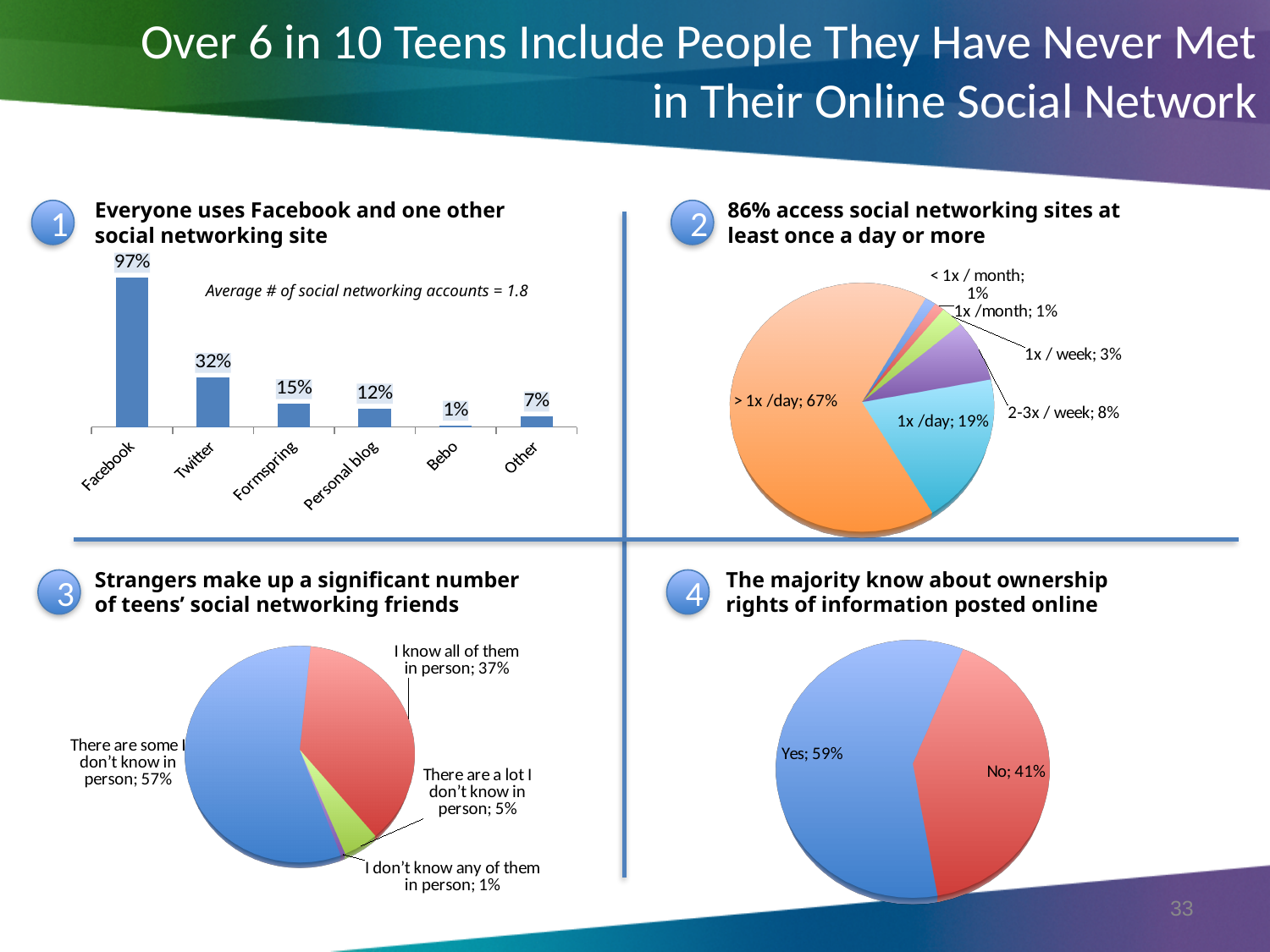
In the top-right pie chart, which is larger: 1x /day or 1x / week? 1x /day In the bottom-left pie chart, which category has the smallest share? I don't know any of them in person In the top-right pie chart, what is the value for 2-3x / week? 8% In the bottom-right pie chart, what is the difference between the Yes and No shares? 18% How many categories are shown in the top-left bar chart? 6 In the top-left bar chart, which social networking site has the lowest value? Bebo In the top-left bar chart, what is the value for Twitter? 32% What type of chart is shown in the top-left of the slide? Bar chart In the top-right pie chart, what share of teens access social networking sites more than once a day (> 1x /day)? 67% In the top-left bar chart, what percentage of teens use Facebook? 97% In the bottom-left pie chart, what percentage of teens say there are some friends they don't know in person? 57% In the top-left bar chart, what is the difference between the values for Formspring and Personal blog? 3%